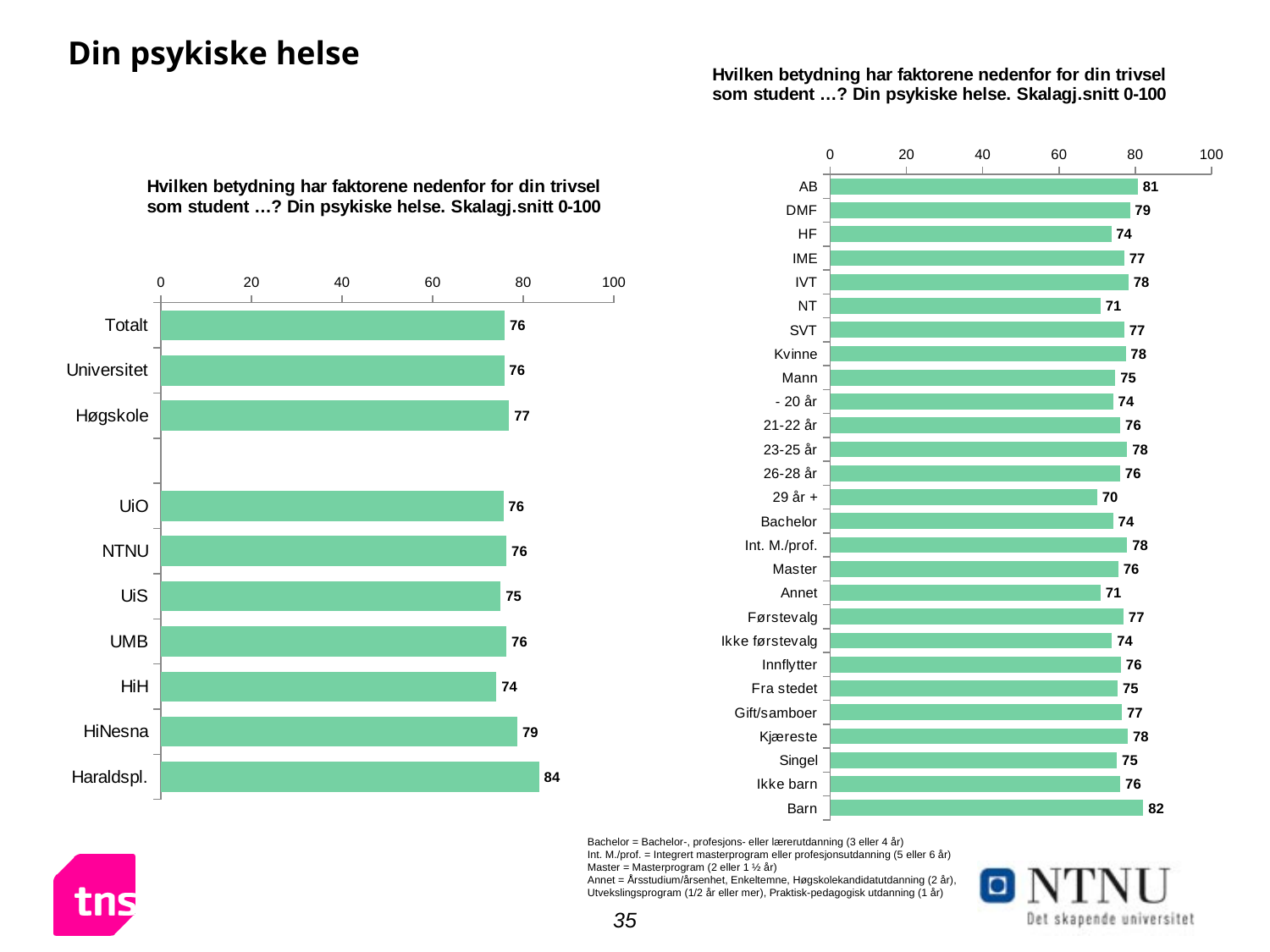
In the left chart, which category has the lowest value? HiH In the right chart, which is larger, the value for Kvinne or the value for Mann? Kvinne In the left chart, how many bars are plotted? 10 In the left chart, what is the value for Haraldspl.? 84 In the right chart, which category has the lowest value? 29 år + What kind of chart is the left chart? Bar chart In the left chart, what is the difference between the values for HiNesna and HiH? 5 In the right chart, what is the value for NT? 71 In the right chart, which category has the highest value? Barn In the left chart, which category has the highest value? Haraldspl. In the right chart, what is the difference between the values for Barn and Ikke barn? 6 In the right chart, how many categories are plotted? 27